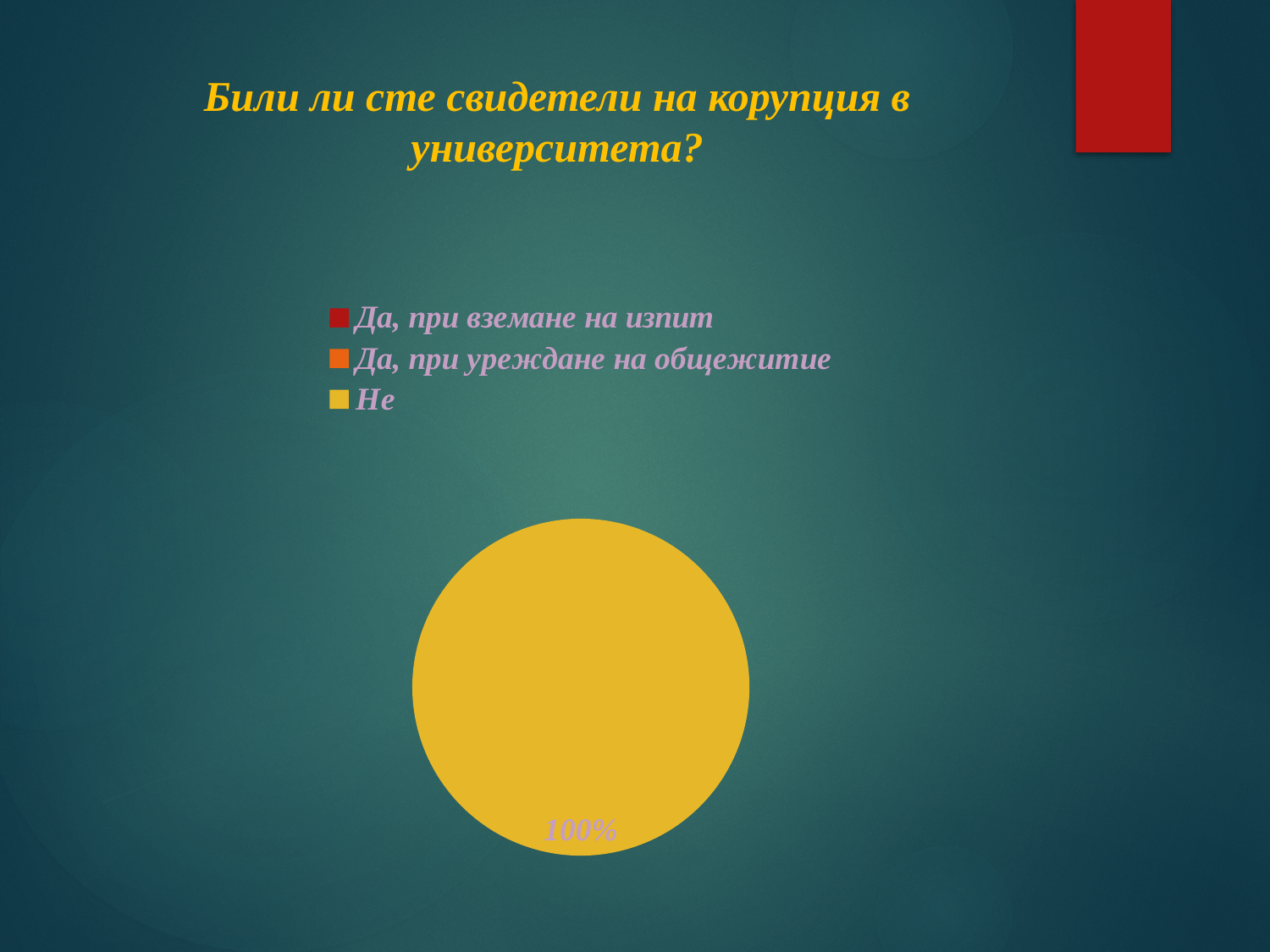
What share of the pie does the "Не" slice take? 100% What colour is the "Не" slice of the pie? yellow How many entries does the legend list? 3 What is the title of the chart? Били ли сте свидетели на корупция в университета? What is the data label printed on the pie chart? 100% Which category has the largest share of the pie? Не Is the share for "Не" greater or less than 50%? greater Which legend entry is listed first? Да, при вземане на изпит What kind of chart is shown on the slide? pie chart